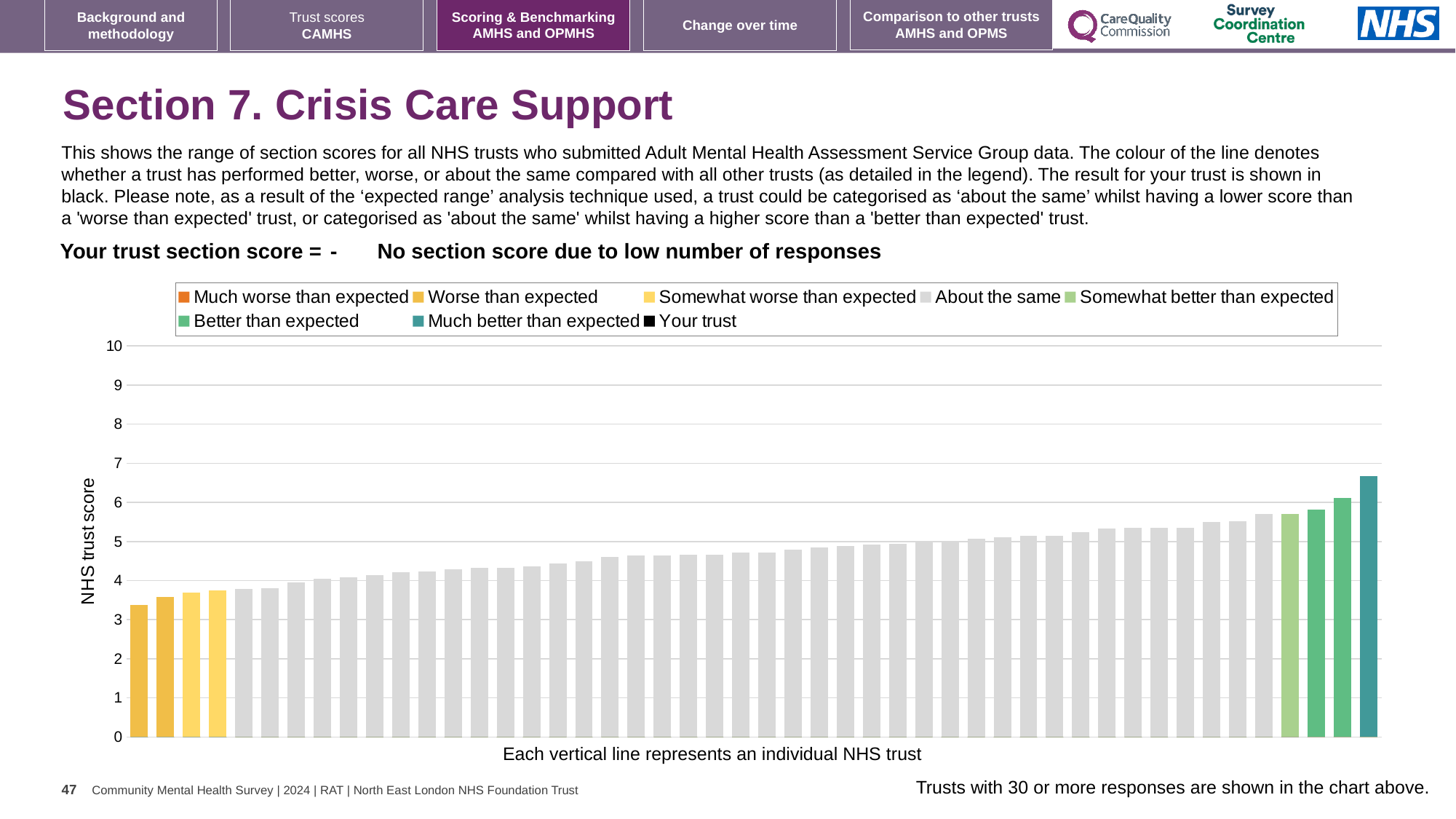
How many entries does the chart legend list? 8 How many bars are coloured as 'Better than expected'? 2 Is the value of the shortest bar greater or less than 4? less Do the bar values rise or fall from left to right along the x axis? rise How many bars are coloured as 'Much better than expected'? 1 Is the value of the 'Much better than expected' bar greater or less than 7? less Is the value of the shortest bar greater or less than 3? greater Which legend category does the highest bar belong to? Much better than expected What is the label on the vertical axis of the chart? NHS trust score What kind of chart is shown on the slide? bar chart Which legend category does the lowest bar belong to? Worse than expected